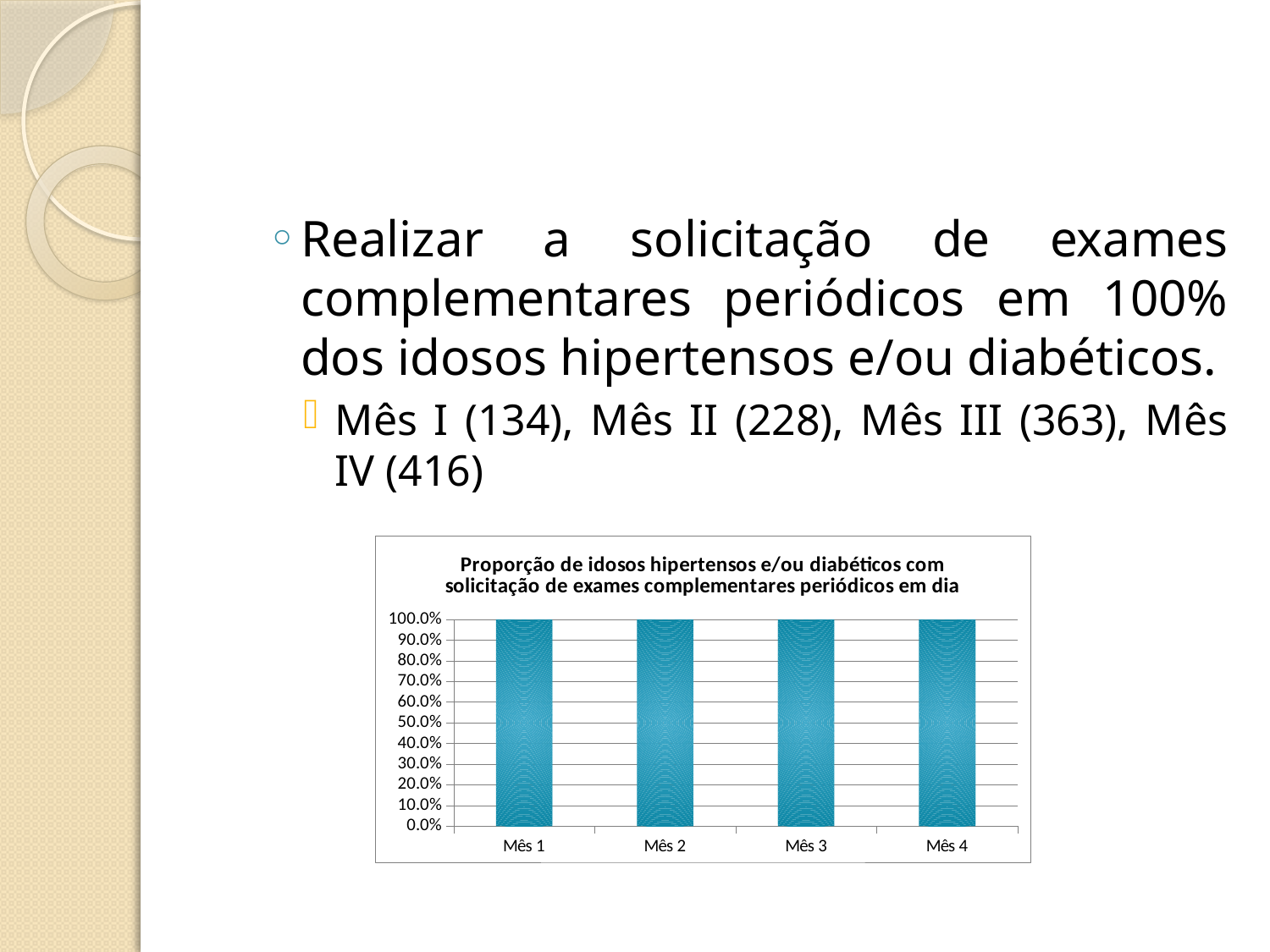
What is the value for Mês 2 in the chart? 100.0% What is the value for Mês 4 in the chart? 100.0% Is the value for Mês 2 greater or less than 50.0%? greater What is the highest value shown on the y axis of the chart? 100.0% What is the label of the first category on the x axis? Mês 1 How many categories are plotted on the x axis of the chart? 4 What is the title of the chart? Proporção de idosos hipertensos e/ou diabéticos com solicitação de exames complementares periódicos em dia What is the difference between the values for Mês 4 and Mês 1? 0.0% What kind of chart is shown on the slide? bar chart What is the value for Mês 3 in the chart? 100.0% What is the value for Mês 1 in the chart? 100.0% Do the values rise, fall, or stay flat from Mês 1 to Mês 4? stay flat